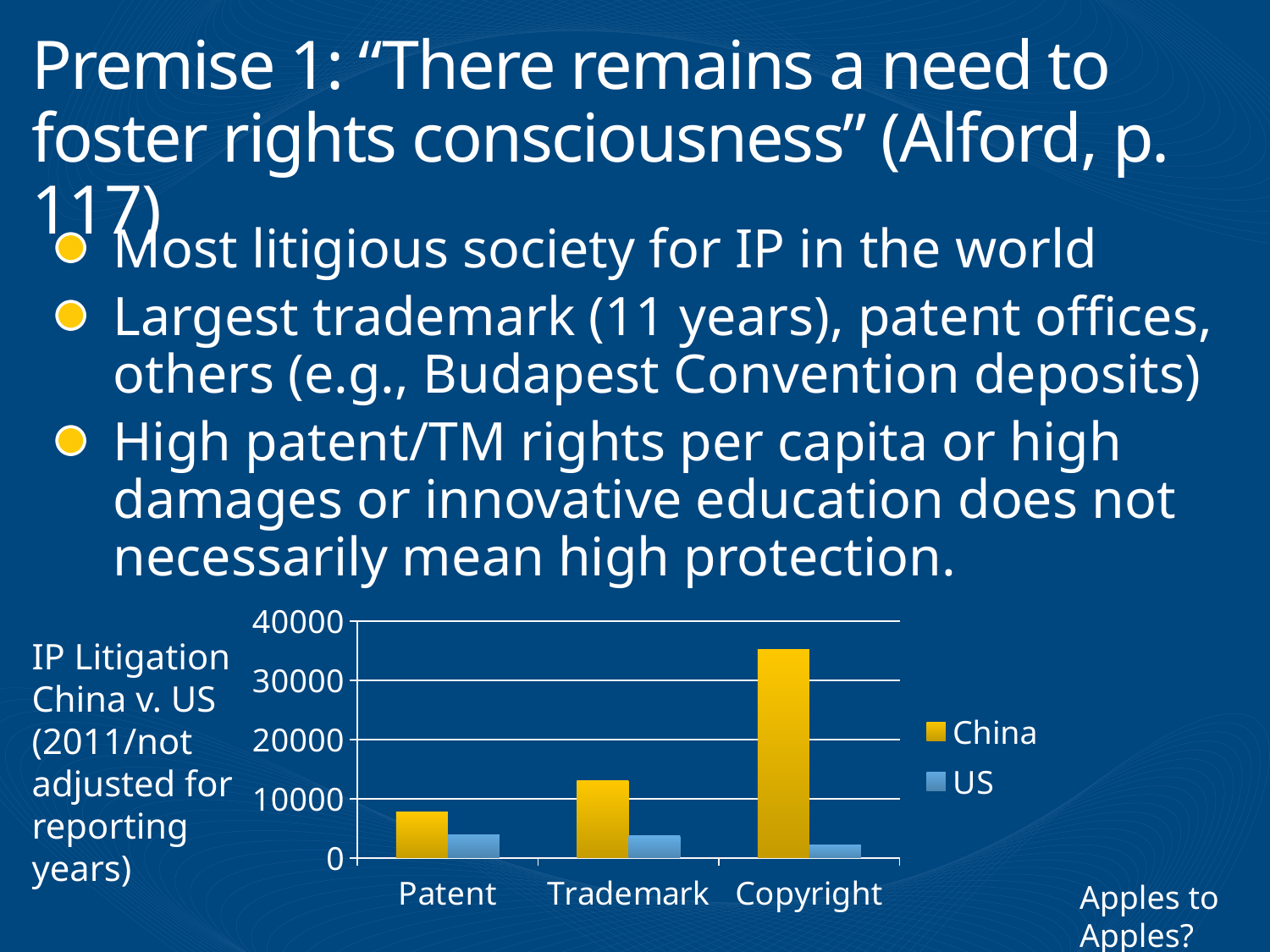
Is the value for China in the Copyright category greater or less than 30000? greater Is the value for China in the Patent category greater or less than 10000? less Which category has the lowest value for US? Copyright Which series are listed in the chart's legend? China and US Which category has the highest value for China? Copyright How many categories are shown on the x axis of the chart? 3 Is the value for US in the Copyright category greater or less than 10000? less For the Copyright category, which is larger: China or US? China How many series does the chart's legend list? 2 What kind of chart is shown on the slide? bar chart Do the values for China rise or fall moving from Patent to Trademark to Copyright? rise